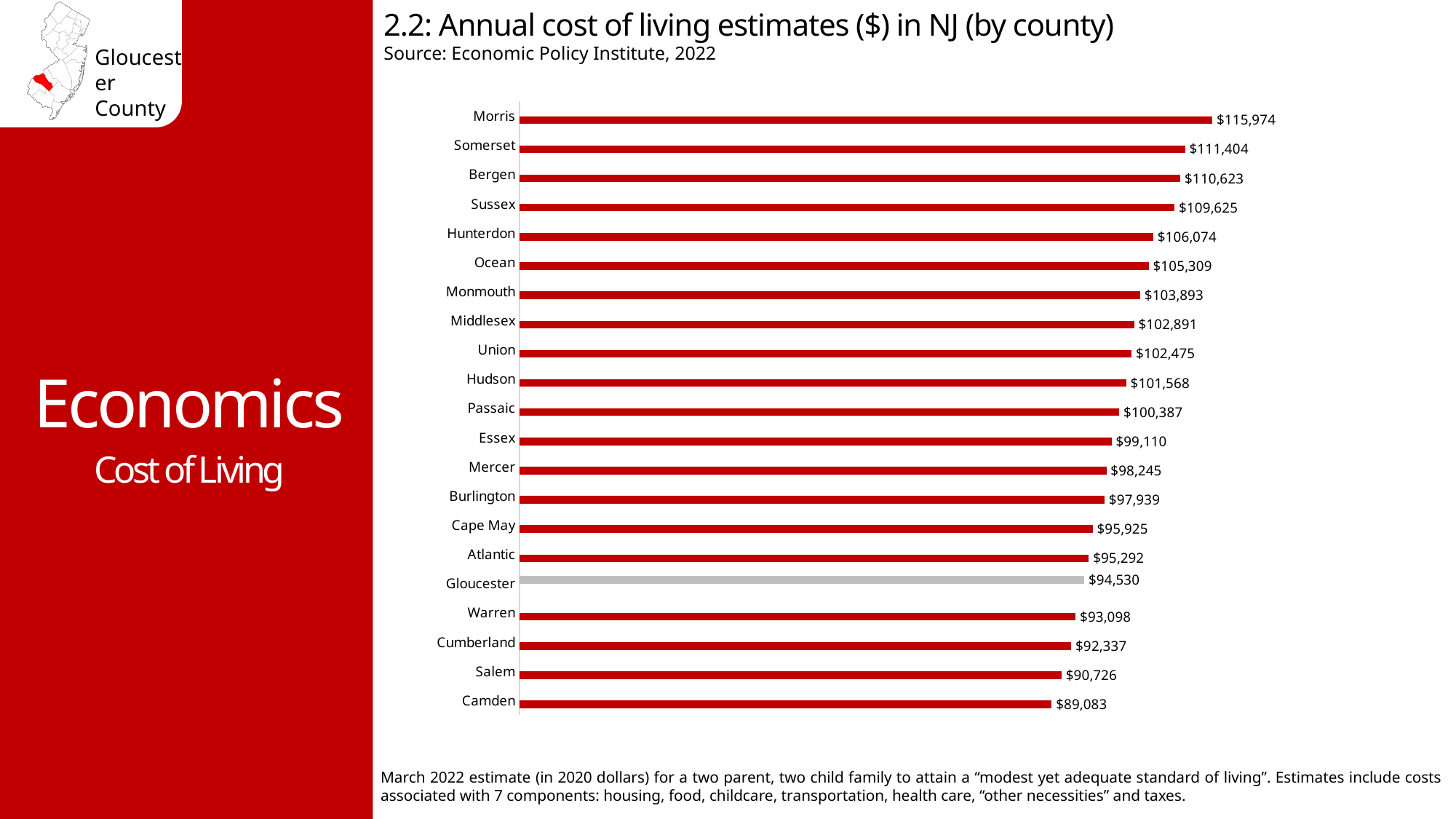
Which county has a higher cost of living estimate, Hunterdon or Ocean? Hunterdon Which county has the highest annual cost of living estimate? Morris What is the annual cost of living estimate for Gloucester County? $94,530 Which county has the lowest annual cost of living estimate? Camden What is the difference between the cost of living estimates for Morris and Camden counties? $26,891 How much higher is Gloucester County's cost of living estimate than Camden County's? $5,447 What is the annual cost of living estimate for Morris County? $115,974 What is the annual cost of living estimate for Cape May County? $95,925 How many counties are shown in the chart? 21 What type of chart is used to show the annual cost of living estimates? Bar chart Which county's bar is shown in gray instead of red? Gloucester Which county has a higher cost of living estimate, Warren or Atlantic? Atlantic